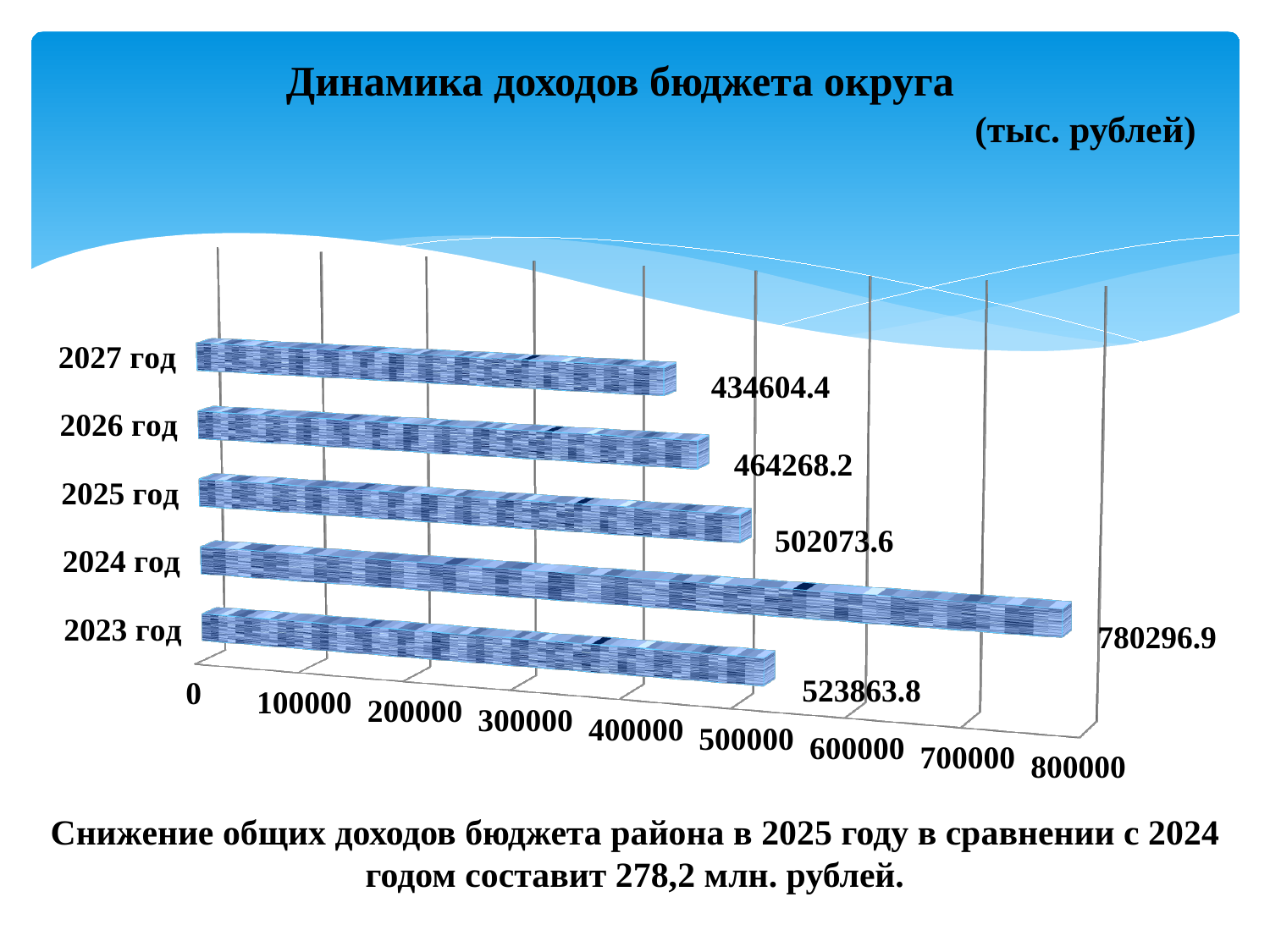
Is the value for 2026 год greater or less than 500000? less What is the value for 2024 год? 780296.9 What is the value for 2023 год? 523863.8 What is the difference between the values for 2024 год and 2025 год? 278223.3 What is the value for 2027 год? 434604.4 What is the difference between the values for 2026 год and 2027 год? 29663.8 Which year has the lowest value? 2027 год Do the values rise or fall from 2025 год to 2027 год? fall Which year has the highest value? 2024 год What kind of chart is shown on the slide? bar chart How many years are shown in the chart? 5 Which is larger, the value for 2023 год or the value for 2025 год? 2023 год